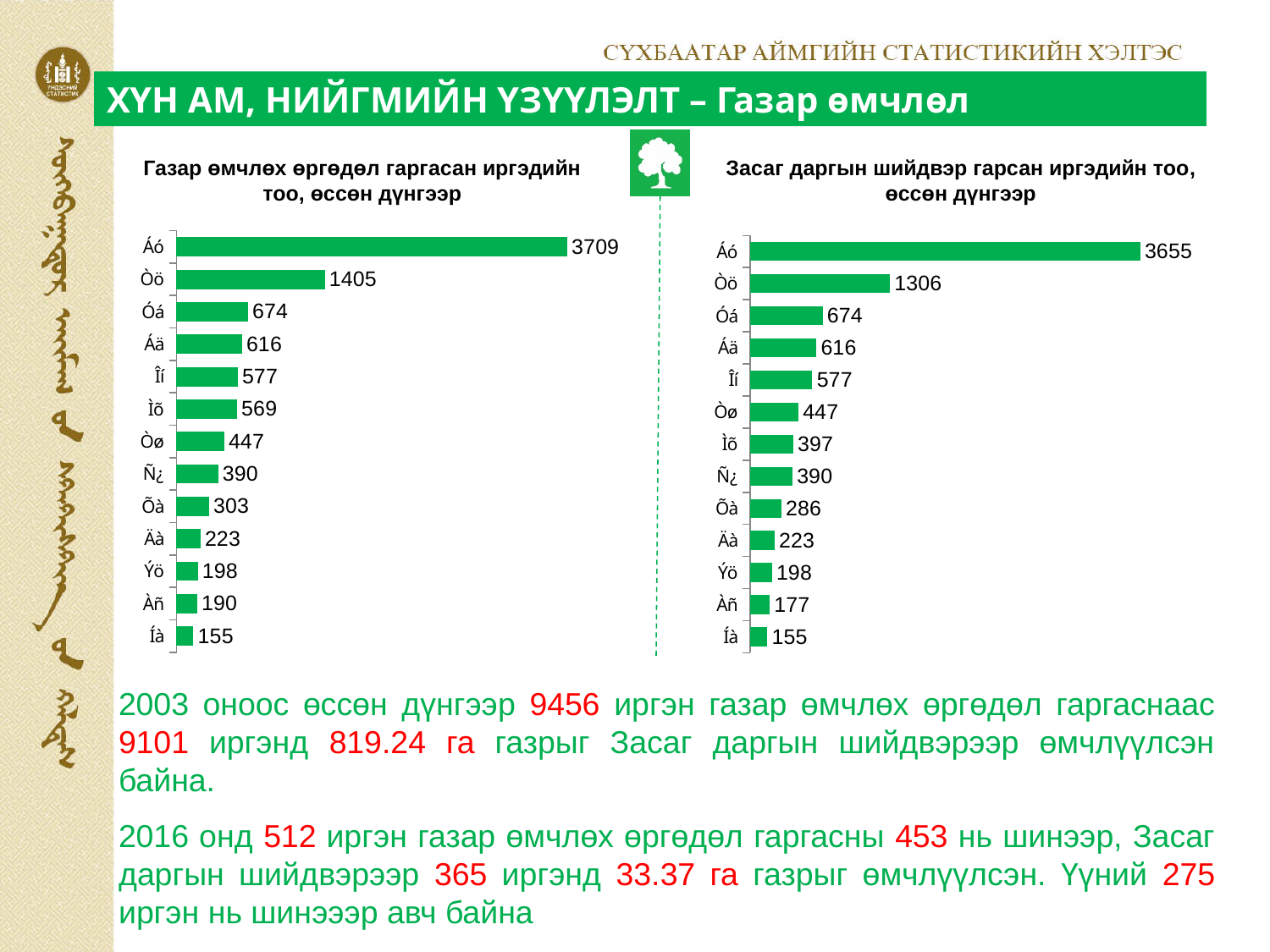
In the right chart (Засаг даргын шийдвэр гарсан иргэдийн тоо), what is the value for Òö? 1306 Which is larger: the value for Òö in the left chart (1405) or the value for Òö in the right chart? the left chart (1405) What is the title of the right chart on the slide? Засаг даргын шийдвэр гарсан иргэдийн тоо, өссөн дүнгээр What kind of chart is the left chart titled "Газар өмчлөх өргөдөл гаргасан иргэдийн тоо, өссөн дүнгээр"? bar chart In the left chart (Газар өмчлөх өргөдөл гаргасан иргэдийн тоо), what is the value of the longest bar, labelled Áó? 3709 In the right chart (Засаг даргын шийдвэр гарсан иргэдийн тоо), what is the value of the longest bar, labelled Áó? 3655 In the left chart (Газар өмчлөх өргөдөл гаргасан иргэдийн тоо), what is the value of the shortest bar, labelled Íà? 155 In the right chart (Засаг даргын шийдвэр гарсан иргэдийн тоо), what is the value for Ìõ? 397 How many bars are shown in the left chart (Газар өмчлөх өргөдөл гаргасан иргэдийн тоо)? 13 In the left chart (Газар өмчлөх өргөдөл гаргасан иргэдийн тоо), what is the value for Ìõ? 569 In the right chart (Засаг даргын шийдвэр гарсан иргэдийн тоо), what is the difference between the values for Áó and Òö? 2349 In the left chart (Газар өмчлөх өргөдөл гаргасан иргэдийн тоо), what is the difference between the values for Áó and Òö? 2304